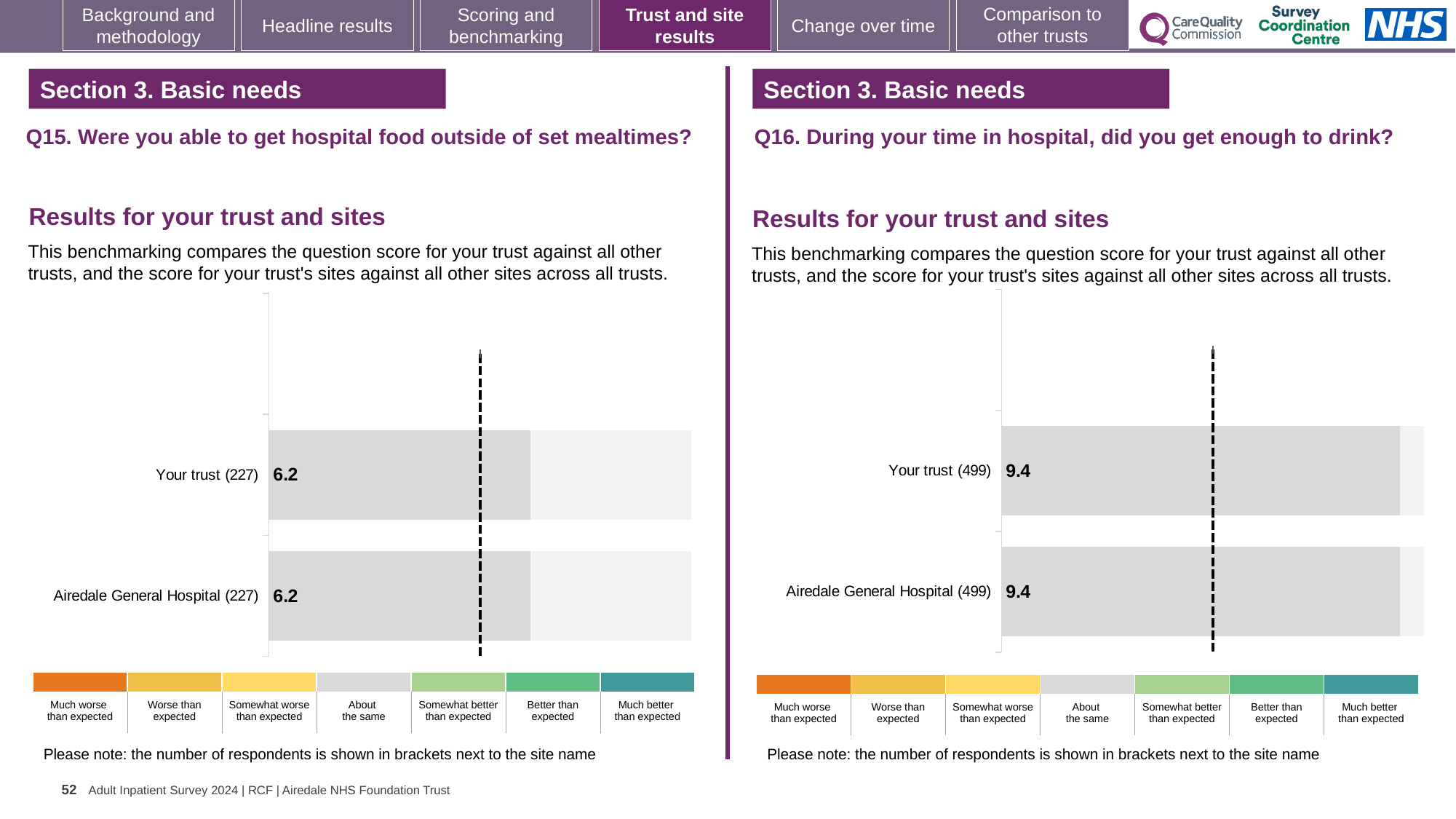
What kind of chart is used on the Q15 chart (left)? Bar chart On the Q16 chart (right), what is the difference between the score for Your trust and the score for Airedale General Hospital? 0.0 On the Q16 chart (right), what is the score for Airedale General Hospital (499)? 9.4 On the Q15 chart (left), which benchmarking category does the grey colour of the bars correspond to in the legend? About the same How many respondents are shown in brackets for Your trust on the Q16 chart (right)? 499 How many bars are plotted on the Q16 chart (right)? 2 On the Q15 chart (left), what is the score for Your trust (227)? 6.2 On the Q15 chart (left), what is the difference between the score for Your trust and the score for Airedale General Hospital? 0.0 On the Q15 chart (left), what is the score for Airedale General Hospital (227)? 6.2 Is the score for Your trust on the Q16 chart (right) larger or smaller than the score for Your trust on the Q15 chart (left)? Larger On the Q16 chart (right), what is the score for Your trust (499)? 9.4 How many bars are plotted on the Q15 chart (left)? 2